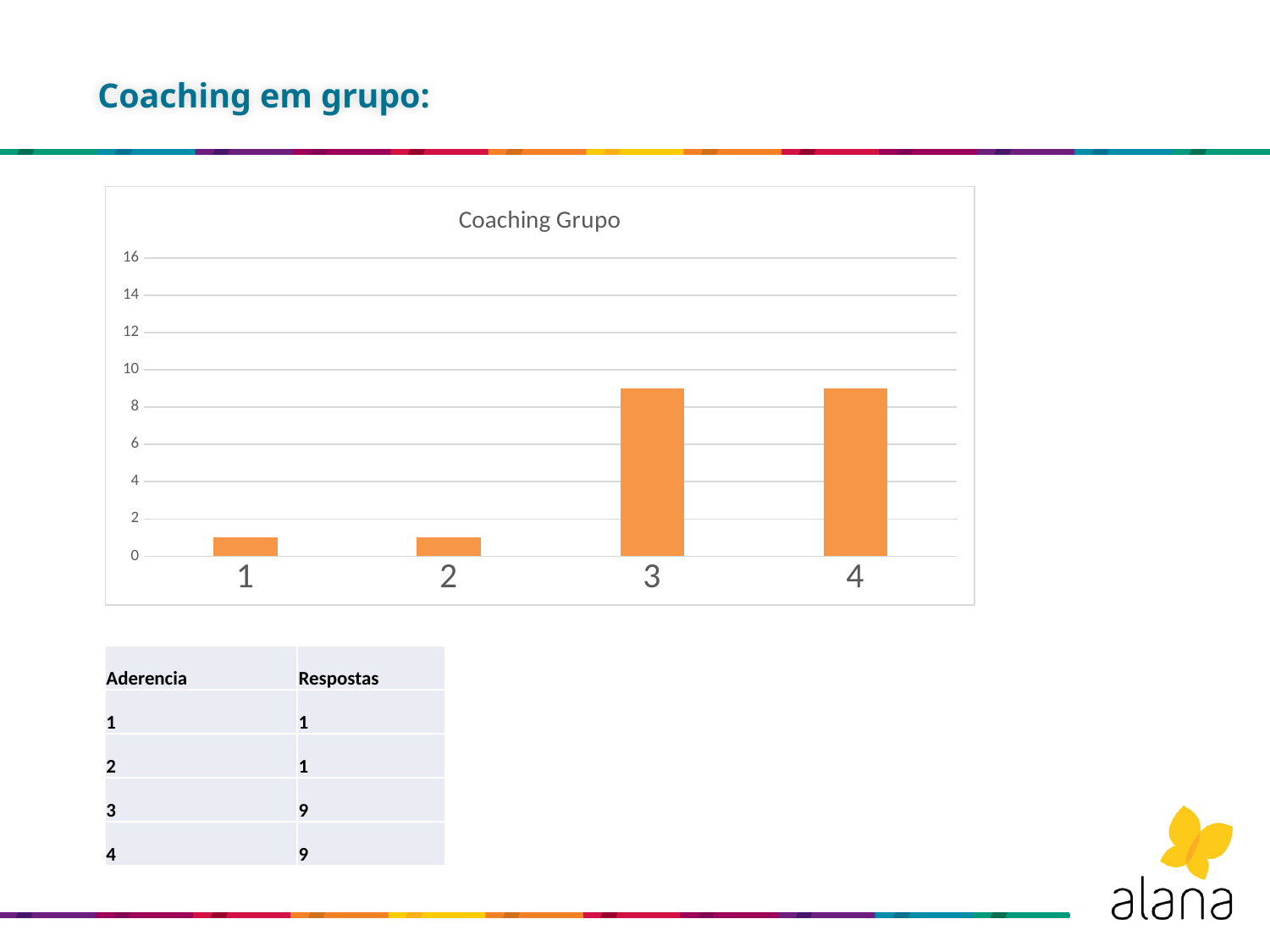
What is the difference between the value for category 4 and the value for category 2? 8 According to the table below the chart, what is the value (Respostas) for category 4? 9 According to the table below the chart, what is the value (Respostas) for category 3? 9 Is the value for category 2 greater or less than 2? less Is the value for category 4 greater or less than 10? less How many bars (categories) does the chart show? 4 Is the value for category 3 greater or less than 8? greater What is the highest value shown on the vertical axis? 16 According to the table below the chart, what is the value (Respostas) for category 1? 1 Which is larger, the value for category 1 or the value for category 3? category 3 What is the title of the chart? Coaching Grupo What kind of chart is shown on the slide? bar chart